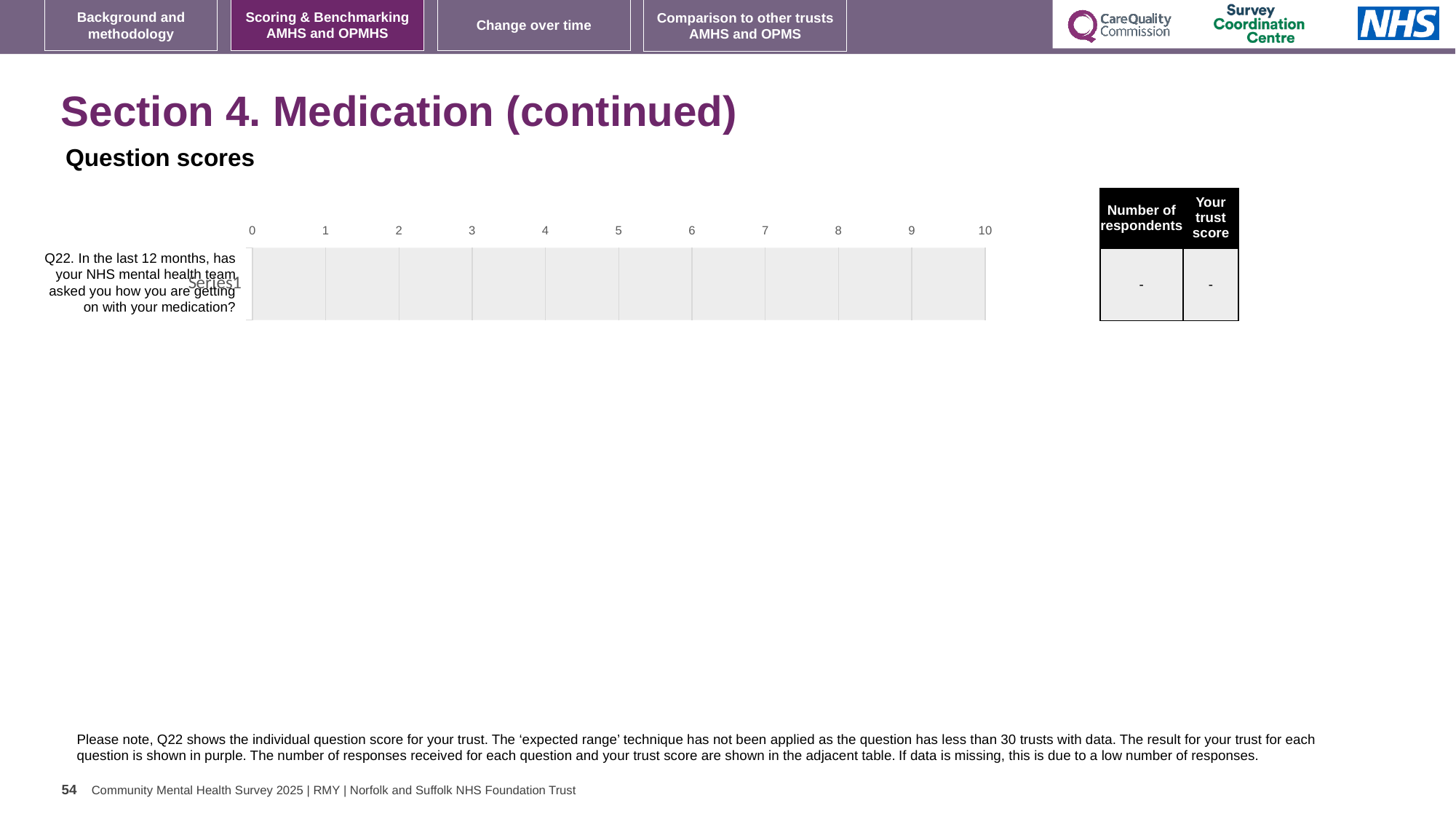
How many question categories are plotted on the chart? 1 Which question number is the category on the chart? Q22 What is shown in the 'Your trust score' column of the table for Q22? - What is the highest value shown on the chart's x axis? 10 What kind of chart is shown on the slide? bar chart What is shown in the 'Number of respondents' column of the table for Q22? -